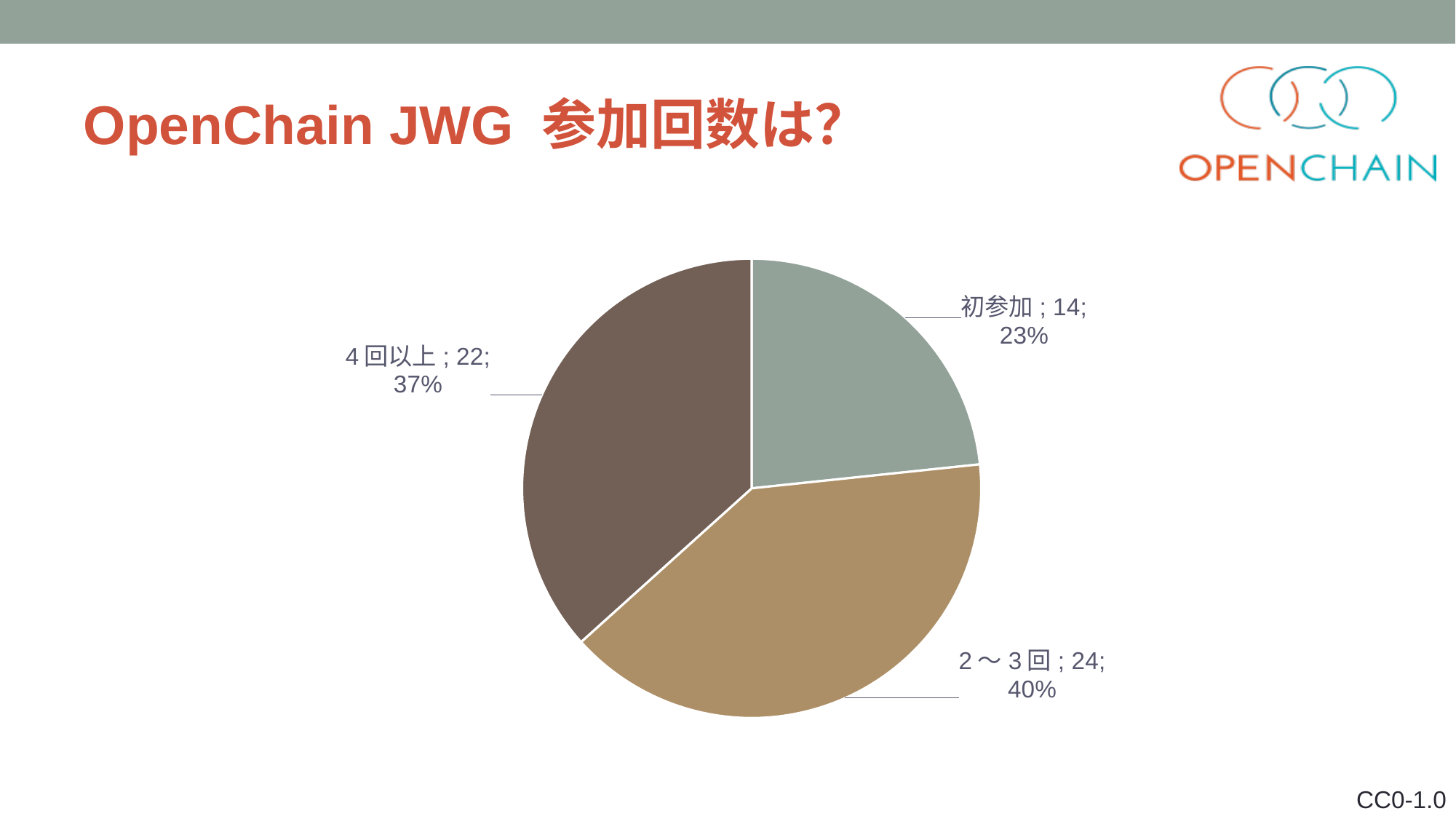
What is the value for 2～3回? 24 What kind of chart is shown on the slide? pie chart What is the difference between the values for 2～3回 and 初参加? 10 Which category has the largest slice? 2～3回 What is the title of the slide containing the chart? OpenChain JWG 参加回数は? What share of the pie does 初参加 represent? 23% Which category has the smallest slice? 初参加 What share of the pie does 2～3回 represent? 40% What is the value for 初参加? 14 How many slices does the pie chart have? 3 What share of the pie does 4回以上 represent? 37% What is the value for 4回以上? 22